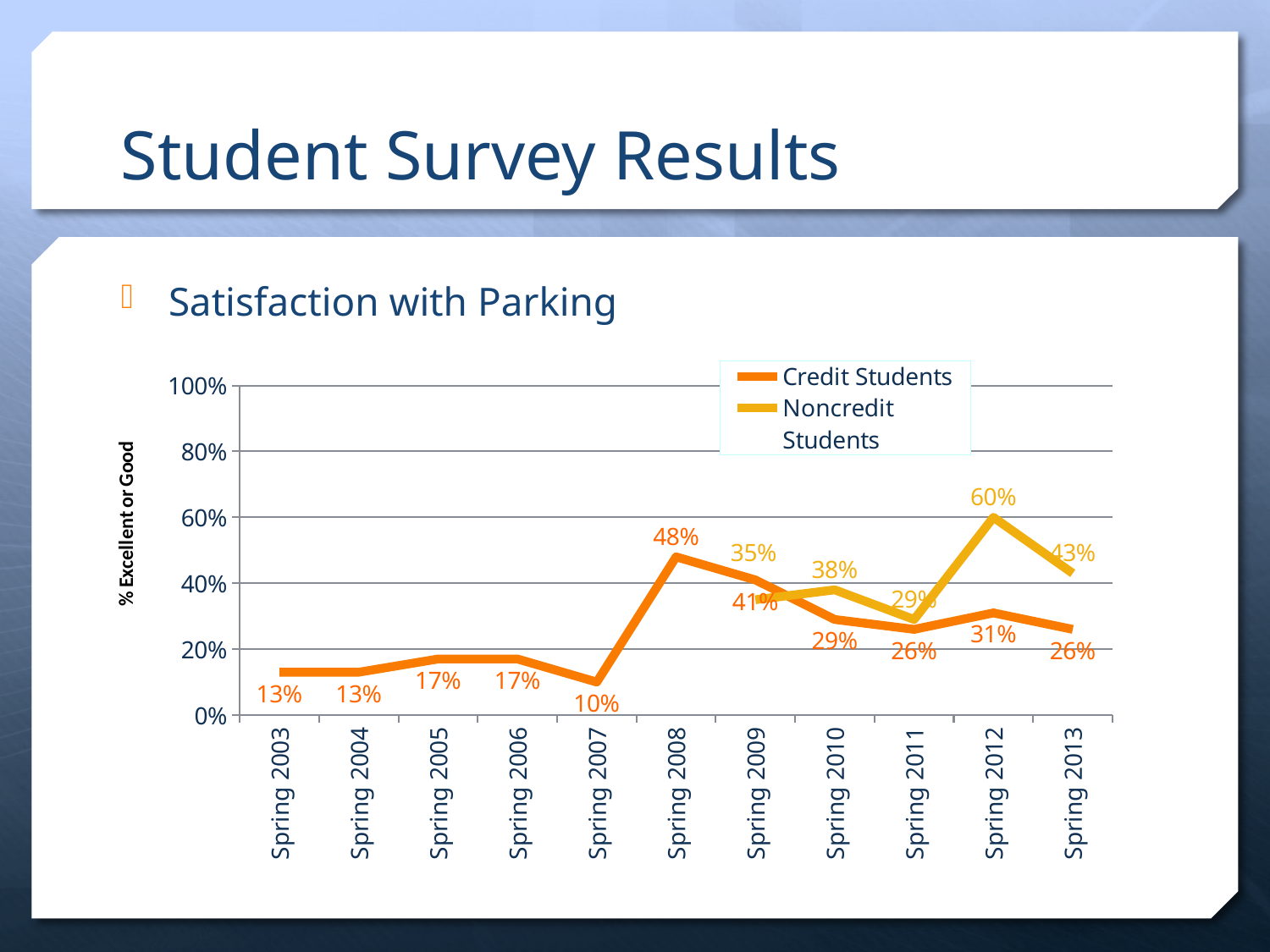
What kind of chart is shown on the slide? Line chart What is the difference between the Noncredit Students and Credit Students values in Spring 2012? 29% In Spring 2009, which group had the higher satisfaction value, Credit Students or Noncredit Students? Credit Students What is the label on the vertical axis of the chart? % Excellent or Good How many series does the legend list? 2 What was the Credit Students value in Spring 2007? 10% How many survey years are shown on the x axis? 11 What was the Noncredit Students value in Spring 2013? 43% What was the Credit Students value in Spring 2008? 48% In which year did Credit Students record their lowest satisfaction with parking? Spring 2007 In which year did Credit Students record their highest satisfaction with parking? Spring 2008 What was the Noncredit Students value in Spring 2012? 60%